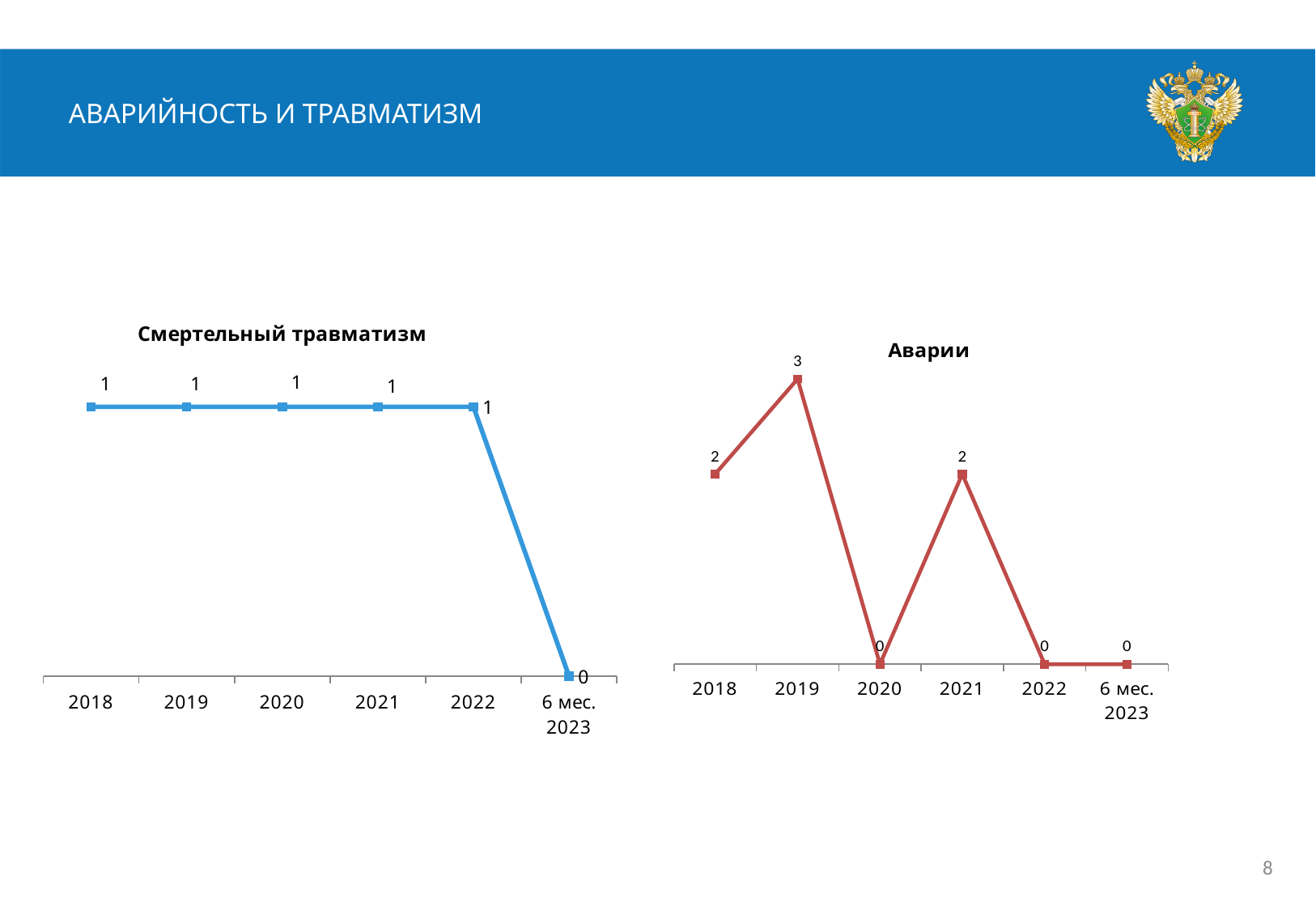
In the 'Аварии' chart, what is the value for 2019? 3 What kind of chart is the 'Аварии' chart? line chart In the 'Смертельный травматизм' chart, what is the value for 2020? 1 In the 'Смертельный травматизм' chart, does the value rise or fall between 2022 and 6 мес. 2023? fall In the 'Аварии' chart, which is larger, the value for 2018 or the value for 2020? 2018 What colour is the line in the 'Смертельный травматизм' chart? blue In the 'Аварии' chart, what is the value for 2021? 2 In the 'Аварии' chart, how many periods have a value of 0? 3 In the 'Аварии' chart, which year has the highest value? 2019 In the 'Аварии' chart, what is the difference between the values for 2019 and 2018? 1 How many data points are plotted in the 'Смертельный травматизм' chart? 6 In the 'Смертельный травматизм' chart, what is the value for 6 мес. 2023? 0